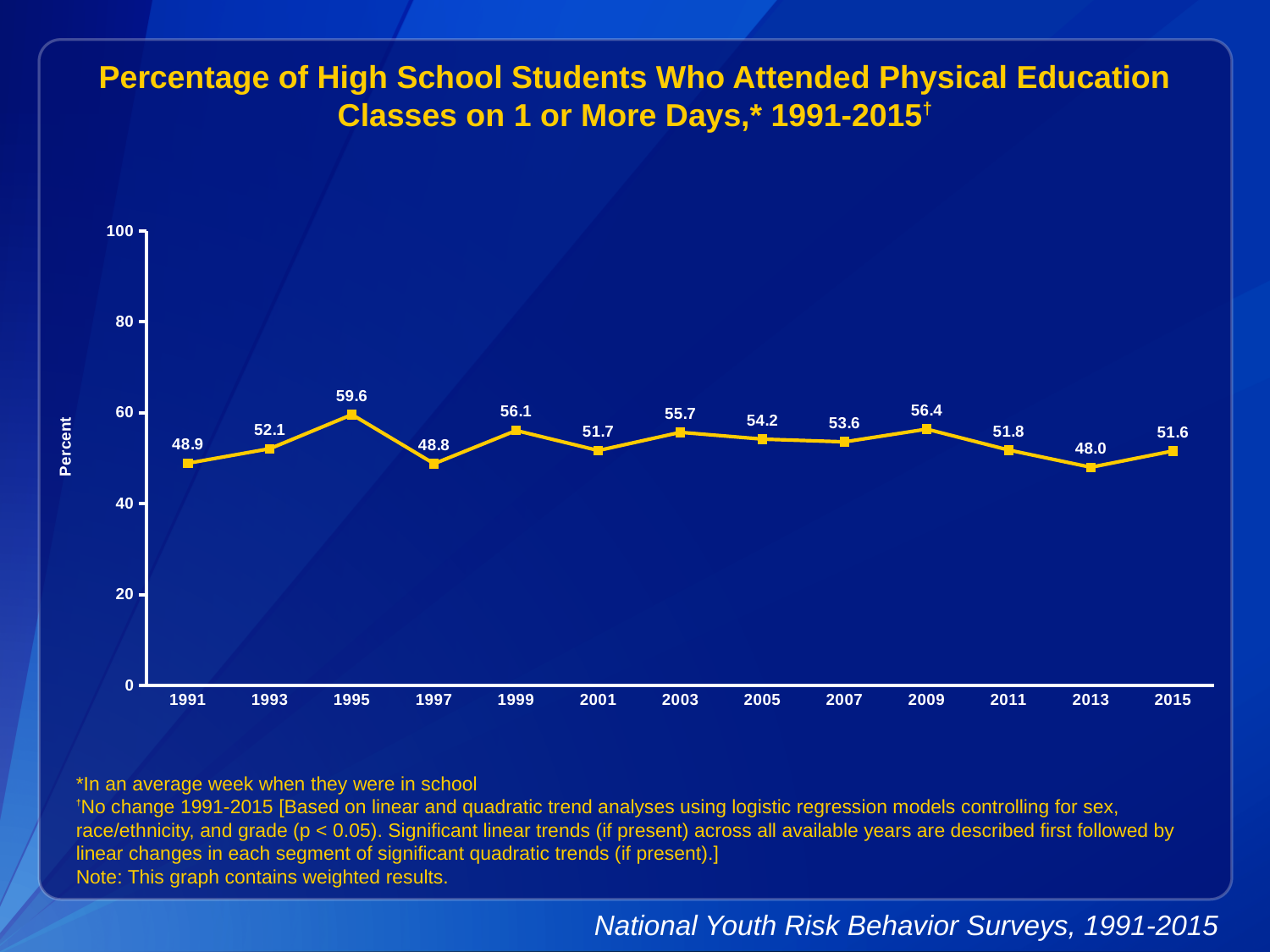
Which year has the lowest percentage? 2013 Is the value for 2003 greater or less than 40? greater What kind of chart is shown on the slide? Line chart What is the label on the y axis? Percent What is the value plotted for 2013? 48.0 What is the difference between the values for 1995 and 1991? 10.7 Which year has the larger value, 1999 or 2001? 1999 What is the difference between the values for 2009 and 2011? 4.6 Which year has the highest percentage? 1995 How many years are plotted on the x axis? 13 What percentage of high school students attended physical education classes on 1 or more days in 1995? 59.6 What is the value plotted for 2015? 51.6